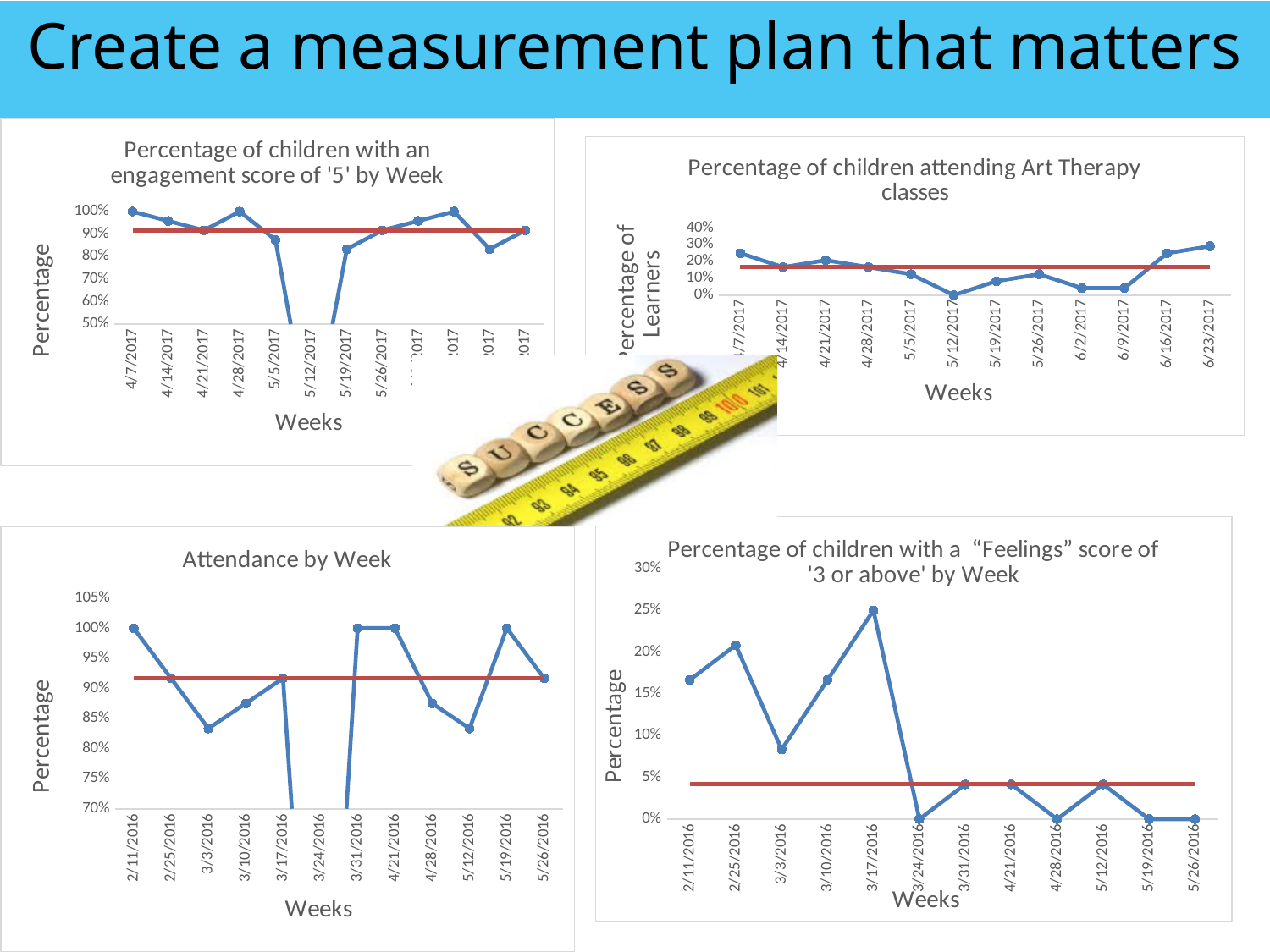
How many weeks are plotted on the x axis of the 'Attendance by Week' chart? 12 In the 'Percentage of children with a "Feelings" score of '3 or above' by Week' chart, which is larger, the value for 2/25/2016 or for 3/3/2016? 2/25/2016 What kind of chart is the 'Attendance by Week' chart? line chart In the 'Percentage of children with an engagement score of '5' by Week' chart, is the value for 5/19/2017 greater or less than 90%? less In the 'Percentage of children attending Art Therapy classes' chart, is the value for 6/23/2017 greater or less than 20%? greater In the 'Percentage of children with an engagement score of '5' by Week' chart, what is the value for 4/7/2017? 100% In the 'Attendance by Week' chart, what is the attendance percentage for 2/11/2016? 100% In the 'Percentage of children with a "Feelings" score of '3 or above' by Week' chart, what is the value for 3/24/2016? 0% In the 'Attendance by Week' chart, is the value for 3/3/2016 greater or less than 90%? less In the 'Percentage of children attending Art Therapy classes' chart, which week has the lowest value? 5/12/2017 In the 'Percentage of children with a "Feelings" score of '3 or above' by Week' chart, which week has the highest value? 3/17/2016